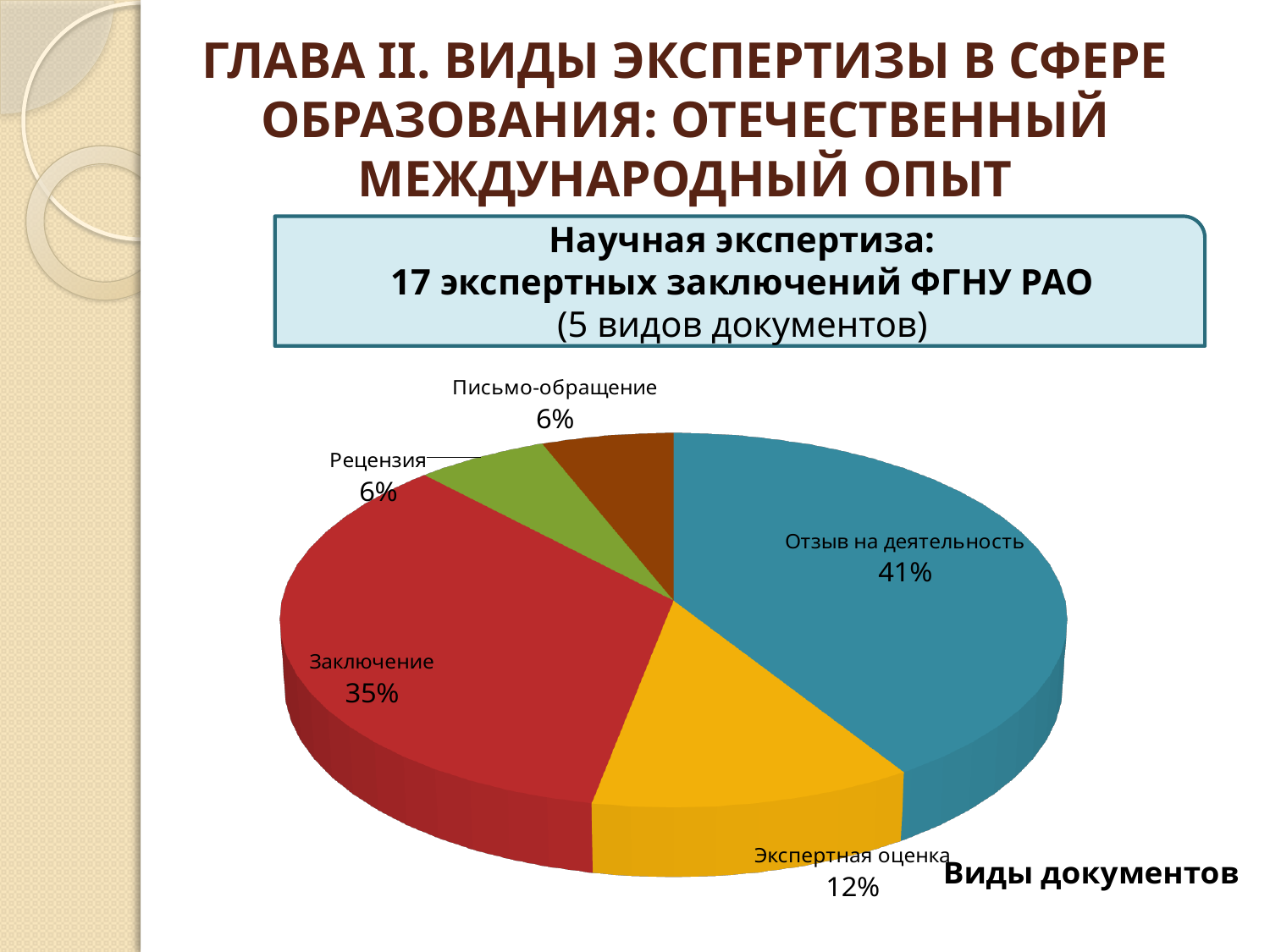
How many slices does the pie chart have? 5 What share of the pie does "Отзыв на деятельность" have? 41% What share of the pie does "Экспертная оценка" have? 12% What kind of chart is shown on the slide? pie chart What is the difference in percentage points between "Отзыв на деятельность" and "Заключение"? 6 What share of the pie does "Заключение" have? 35% What is the difference in percentage points between "Заключение" and "Экспертная оценка"? 23 Which category has the largest slice of the pie? Отзыв на деятельность What label appears at the bottom right of the chart? Виды документов Which is larger, the share for "Заключение" or the share for "Экспертная оценка"? Заключение